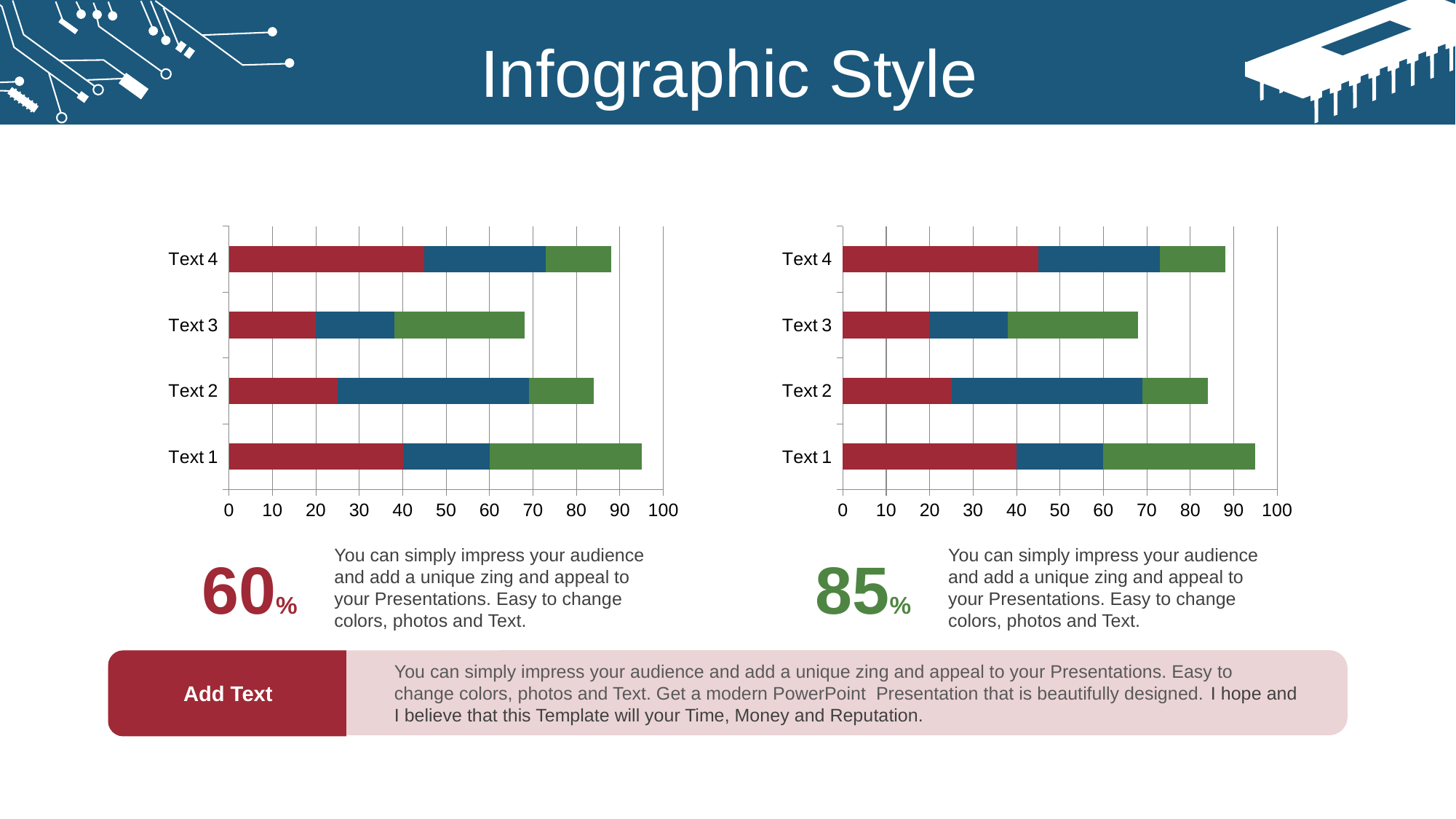
In the right chart, which category has the shortest total bar? Text 3 In the right chart, which category has the longest total bar? Text 1 How many categories does the right chart show? 4 In the left chart, which category has the shortest total bar? Text 3 What is the highest value shown on the x axis of the left chart? 100 In the left chart, which category has the longest total bar? Text 1 In the right chart, is the total bar length for Text 1 greater or less than 90? greater What kind of chart is the left chart? bar chart In the right chart, is the red segment for Text 4 greater or less than 40? greater How many categories does the left chart show? 4 In the left chart, which total bar is longer, Text 2 or Text 4? Text 4